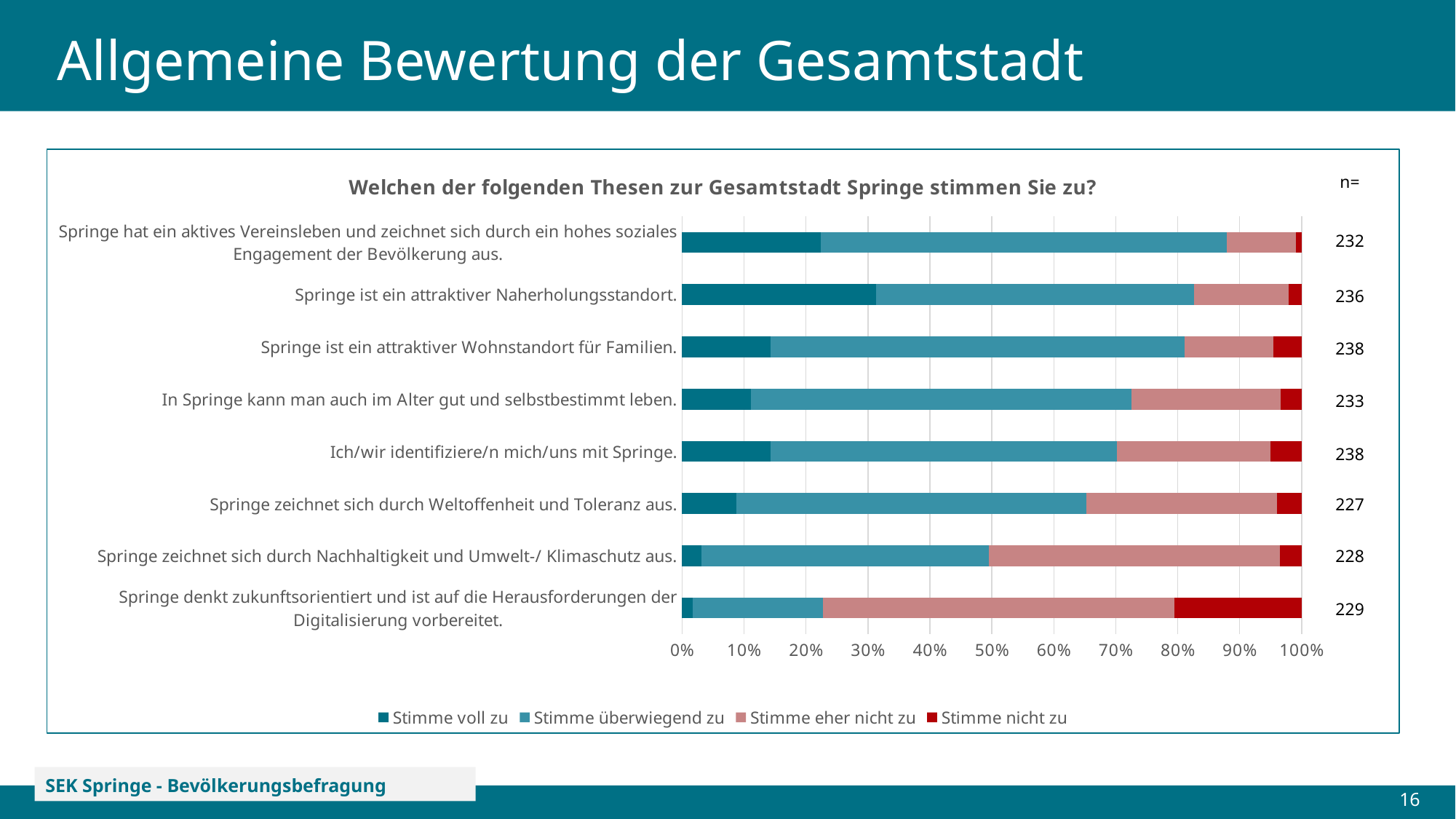
How many statements (categories) are plotted in the chart? 8 What is the n value shown for "Springe zeichnet sich durch Weltoffenheit und Toleranz aus."? 227 Which statement has the larger "Stimme voll zu" share: "Springe ist ein attraktiver Naherholungsstandort." or "Springe zeichnet sich durch Nachhaltigkeit und Umwelt-/ Klimaschutz aus."? Springe ist ein attraktiver Naherholungsstandort. What is the difference between the n values for "Springe ist ein attraktiver Wohnstandort für Familien." and "Springe zeichnet sich durch Weltoffenheit und Toleranz aus."? 11 Which statement has the lowest n value? Springe zeichnet sich durch Weltoffenheit und Toleranz aus. What is the n value shown for "Springe ist ein attraktiver Naherholungsstandort."? 236 What kind of chart is shown on the slide? Stacked bar chart How many series does the legend list? 4 What is the title of the chart? Welchen der folgenden Thesen zur Gesamtstadt Springe stimmen Sie zu? Is the "Stimme voll zu" share for "Springe ist ein attraktiver Naherholungsstandort." greater or less than 20%? greater Which legend entry is shown in red? Stimme nicht zu Is the "Stimme nicht zu" share for "Springe denkt zukunftsorientiert und ist auf die Herausforderungen der Digitalisierung vorbereitet." greater or less than 10%? greater